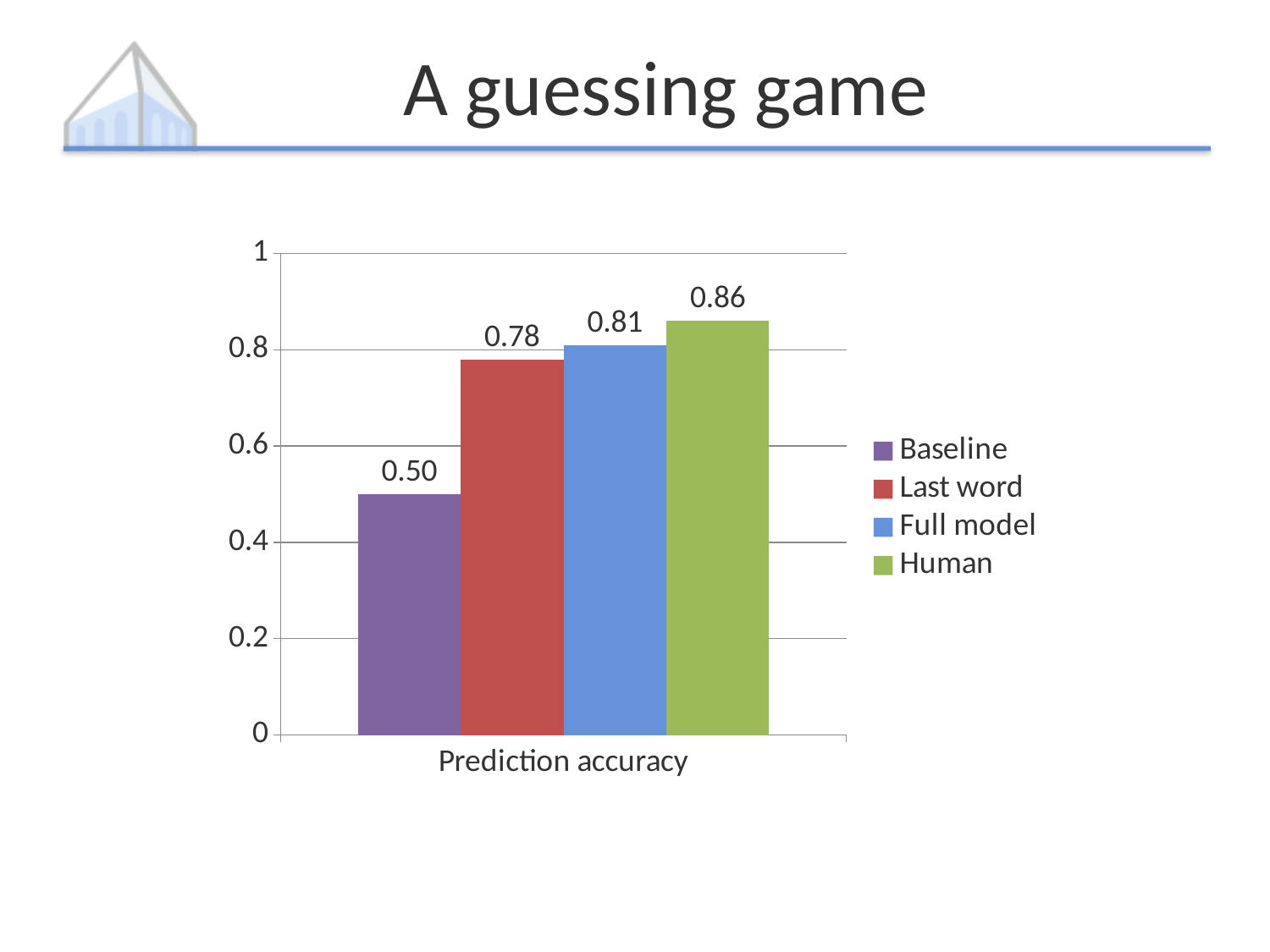
Which series has the highest prediction accuracy? Human Which series has the lowest prediction accuracy? Baseline How many series does the legend list? 4 Which has a higher prediction accuracy, Last word or Full model? Full model What is the prediction accuracy for the Baseline series? 0.50 Is the prediction accuracy for Baseline greater or less than 0.6? less What kind of chart is shown on the slide? Bar chart What is the difference in prediction accuracy between Human and Full model? 0.05 What is the prediction accuracy for the Full model series? 0.81 What is the difference in prediction accuracy between Full model and Baseline? 0.31 What is the prediction accuracy for the Human series? 0.86 What is the prediction accuracy for the Last word series? 0.78